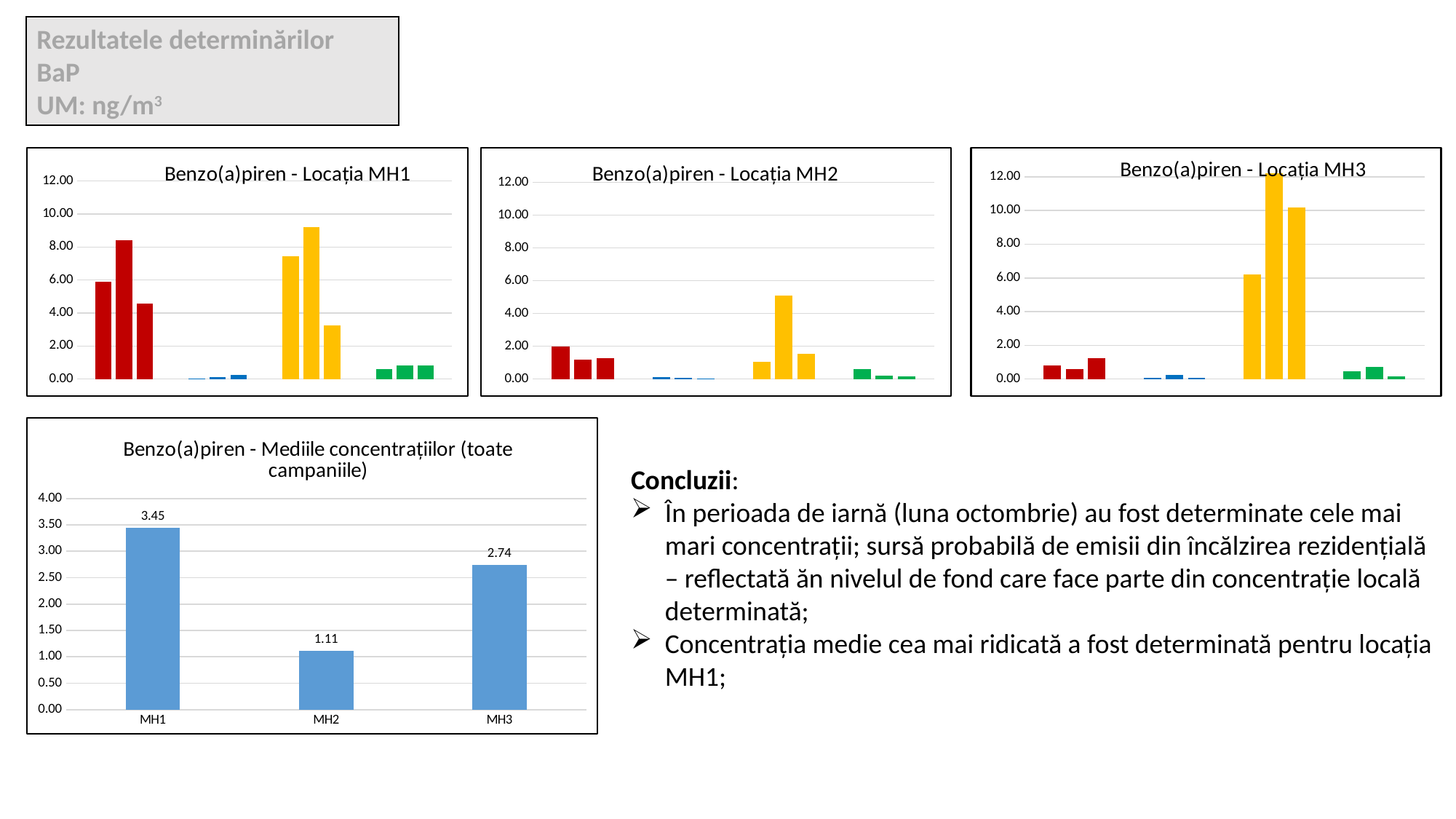
In the chart titled 'Benzo(a)piren - Locația MH2', is the tallest bar greater or less than 6.00? less In the chart titled 'Benzo(a)piren - Mediile concentrațiilor (toate campaniile)', which location has the highest value? MH1 In the chart titled 'Benzo(a)piren - Mediile concentrațiilor (toate campaniile)', what is the value for MH3? 2.74 In the chart titled 'Benzo(a)piren - Mediile concentrațiilor (toate campaniile)', what is the difference between the values for MH1 and MH2? 2.34 What kind of chart is 'Benzo(a)piren - Mediile concentrațiilor (toate campaniile)'? bar chart How many locations are shown in the chart titled 'Benzo(a)piren - Mediile concentrațiilor (toate campaniile)'? 3 In the chart titled 'Benzo(a)piren - Mediile concentrațiilor (toate campaniile)', what is the difference between the values for MH1 and MH3? 0.71 In the chart titled 'Benzo(a)piren - Mediile concentrațiilor (toate campaniile)', which location has the lowest value? MH2 In the chart titled 'Benzo(a)piren - Locația MH3', is the tallest bar greater or less than 10.00? greater In the chart titled 'Benzo(a)piren - Mediile concentrațiilor (toate campaniile)', which is larger, the value for MH3 or the value for MH2? MH3 In the chart titled 'Benzo(a)piren - Mediile concentrațiilor (toate campaniile)', what is the value for MH1? 3.45 In the chart titled 'Benzo(a)piren - Mediile concentrațiilor (toate campaniile)', what is the value for MH2? 1.11